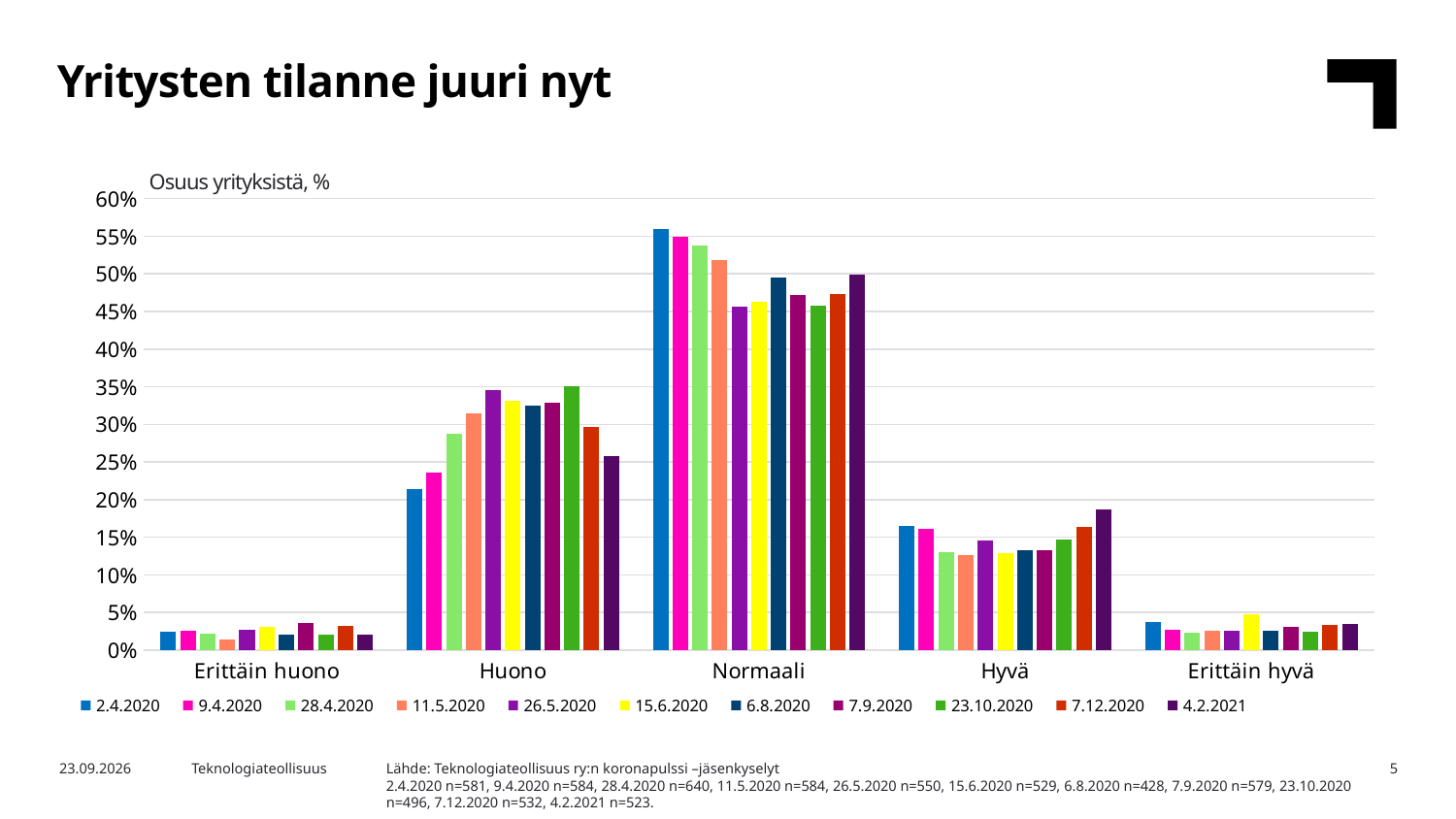
Which category has the tallest bars overall? Normaali Is the value for 2.4.2020 in the Erittäin huono category greater or less than 5%? less What kind of chart is shown on the slide? bar chart How many categories are shown on the x axis? 5 In the Hyvä category, which is larger: the value for 28.4.2020 or the value for 4.2.2021? 4.2.2021 Is the value for 2.4.2020 in the Normaali category greater or less than 50%? greater In the Huono category, which is larger: the value for 2.4.2020 or the value for 4.2.2021? 4.2.2021 Is the value for 4.2.2021 in the Huono category greater or less than 30%? less What is the label shown above the vertical axis of the chart? Osuus yrityksistä, % In the Huono category, do the values rise or fall from 2.4.2020 to 26.5.2020? rise How many series does the legend list? 11